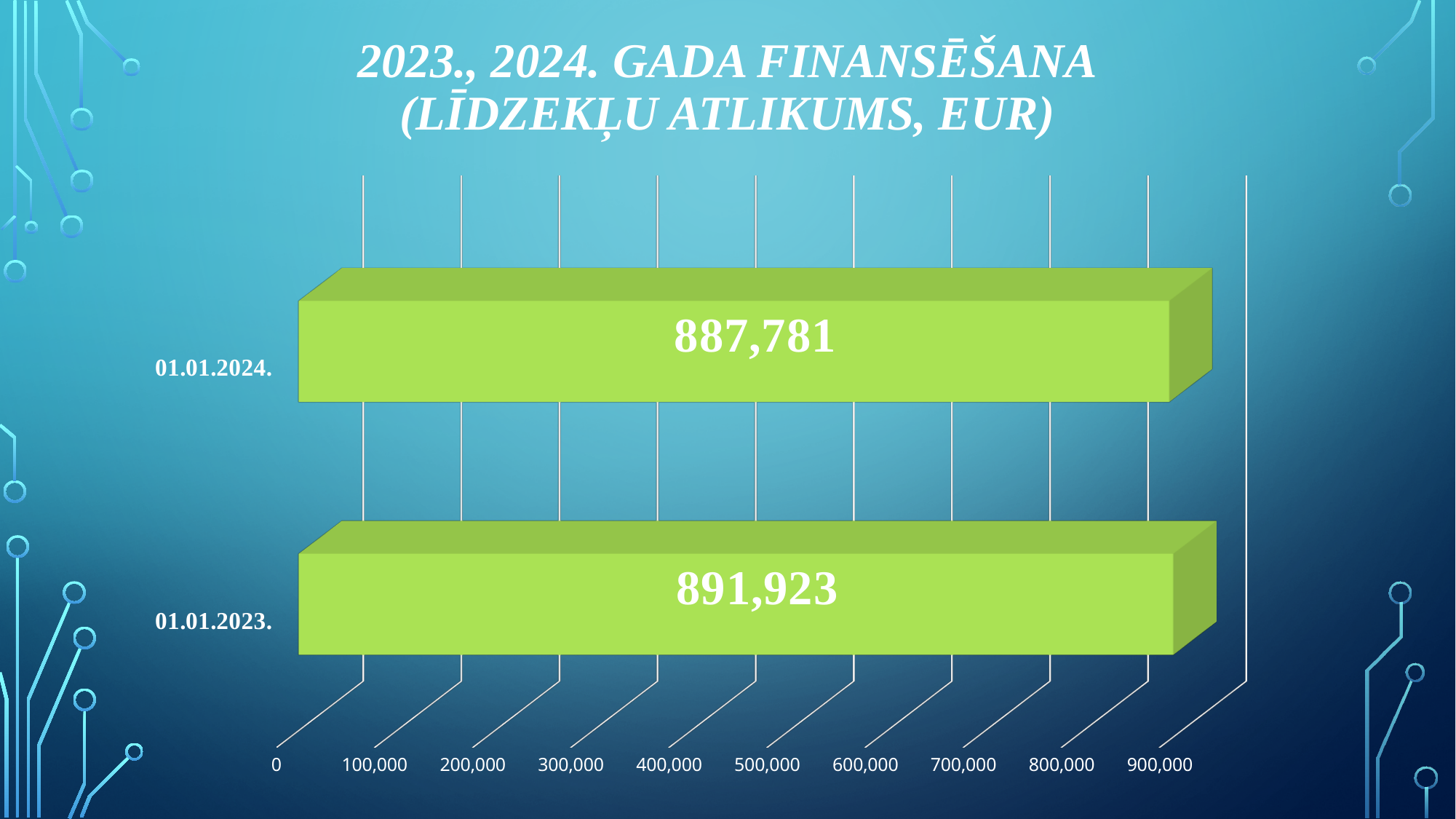
How many categories are shown in the chart? 2 Which category has the highest value? 01.01.2023. What kind of chart is shown on the slide? bar chart What colour are the bars in the chart? green What is the value for 01.01.2024.? 887,781 What is the value for 01.01.2023.? 891,923 Is the value for 01.01.2024. greater or less than 800,000? greater Which is larger, the value for 01.01.2023. or the value for 01.01.2024.? 01.01.2023. Is the value for 01.01.2023. greater or less than 900,000? less What is the difference between the values for 01.01.2023. and 01.01.2024.? 4,142 What is the title of the chart? 2023., 2024. gada finansēšana (līdzekļu atlikums, EUR) Which category has the lowest value? 01.01.2024.